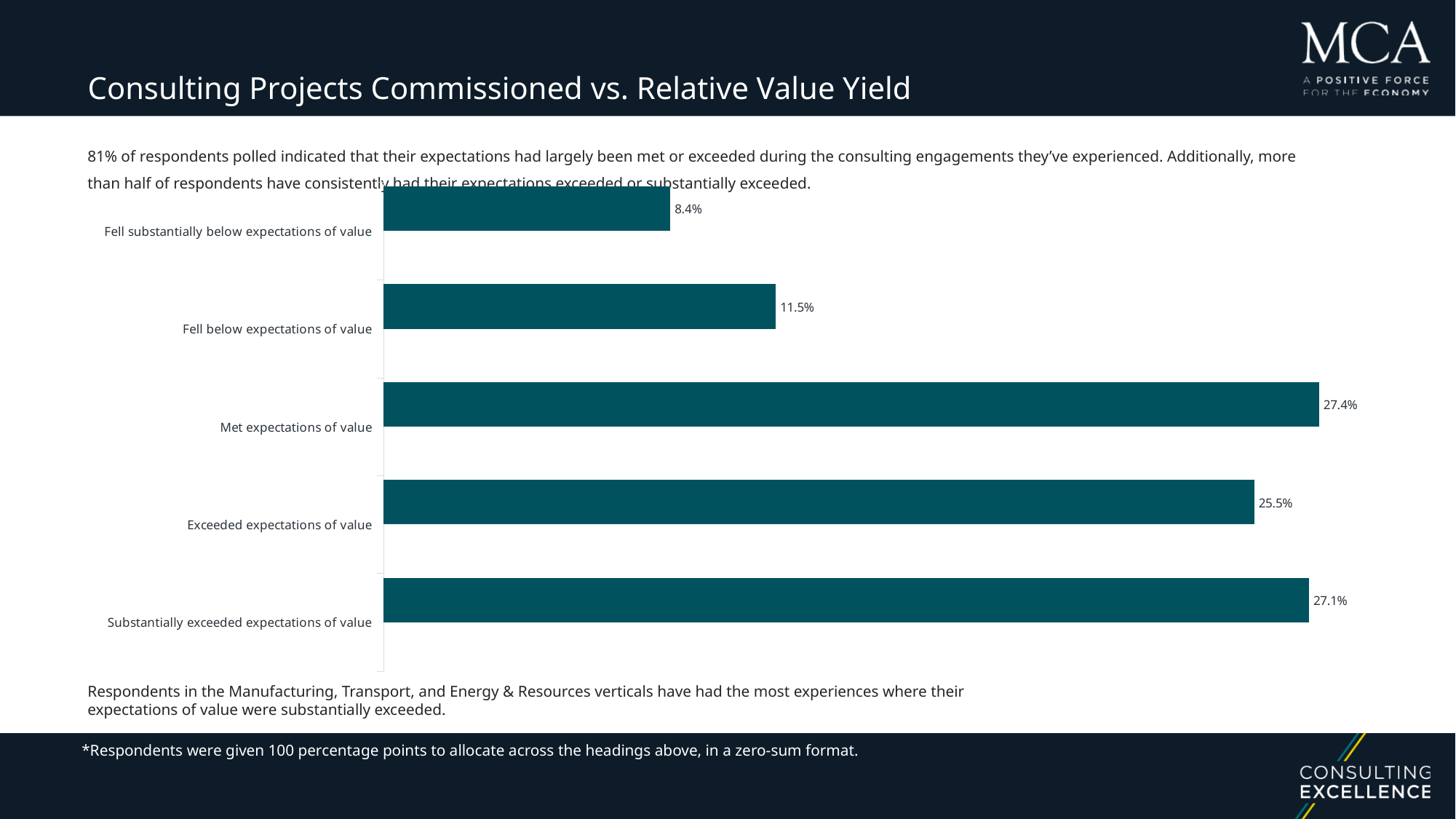
Which category has the highest value in the chart? Met expectations of value What is the title of the slide containing the chart? Consulting Projects Commissioned vs. Relative Value Yield What type of chart is shown on the slide? Bar chart Which is larger: the value for "Exceeded expectations of value" or "Fell below expectations of value"? Exceeded expectations of value What percentage is shown for "Fell below expectations of value"? 11.5% How many categories are plotted in the chart? 5 What is the difference between the values for "Fell below expectations of value" and "Fell substantially below expectations of value"? 3.1% What value is shown for "Substantially exceeded expectations of value"? 27.1% What percentage is shown for "Met expectations of value"? 27.4% Which category has the lowest value in the chart? Fell substantially below expectations of value What value is labelled on the bar for "Fell substantially below expectations of value"? 8.4% What percentage is shown for "Exceeded expectations of value"? 25.5%